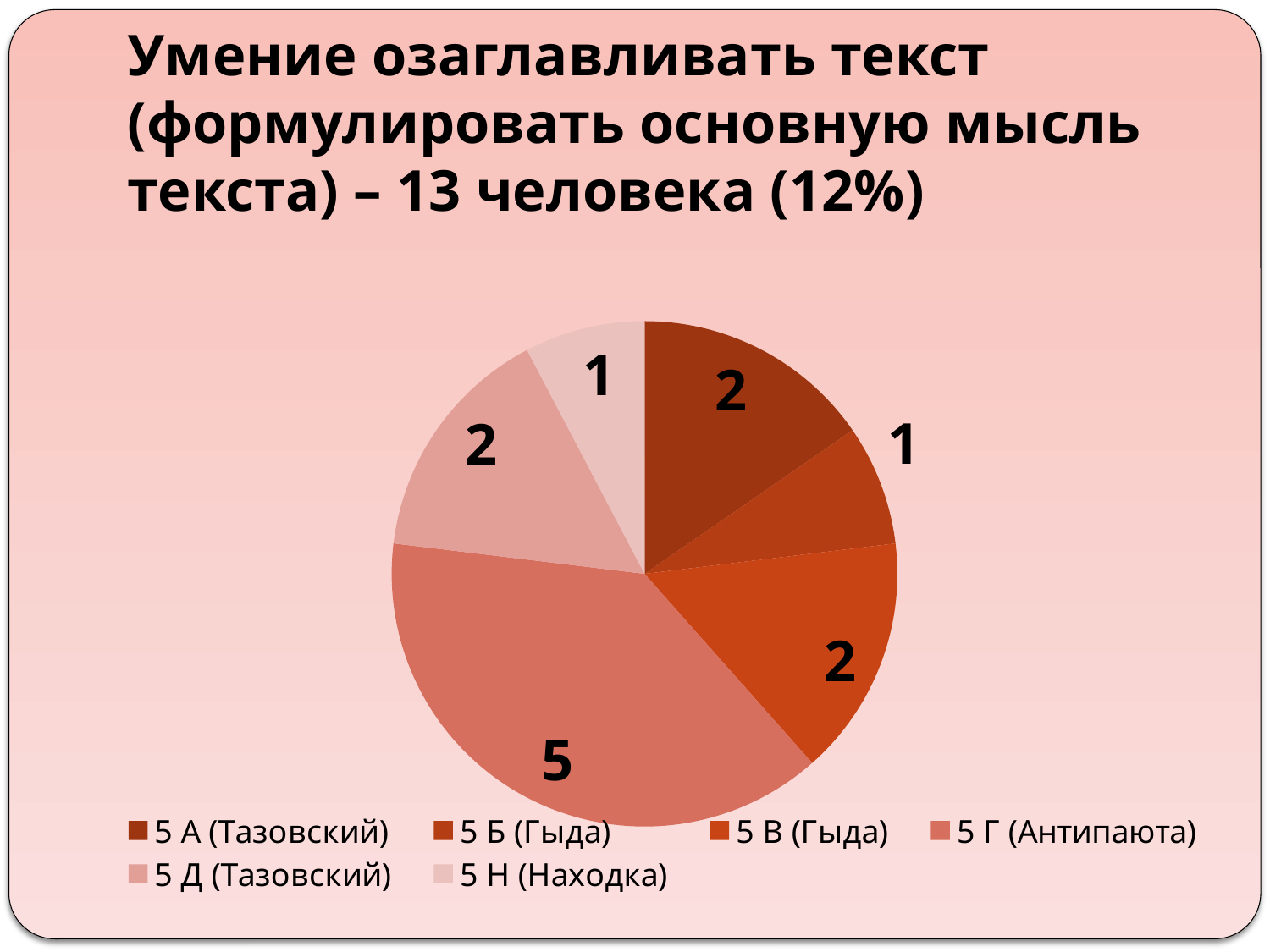
What is the value for 5 Н (Находка)? 1 What is the value for 5 Г (Антипаюта)? 5 What is the value for 5 Д (Тазовский)? 2 What kind of chart is shown on the slide? pie chart What is the difference between the values for 5 Г (Антипаюта) and 5 В (Гыда)? 3 What is the value for 5 Б (Гыда)? 1 What is the total of all the slices in the pie? 13 How many people does the slide title say the chart covers? 13 Which category has the largest slice of the pie? 5 Г (Антипаюта) How many categories does the legend list? 6 Which is larger, the value for 5 А (Тазовский) or the value for 5 Б (Гыда)? 5 А (Тазовский) What is the value for 5 А (Тазовский)? 2